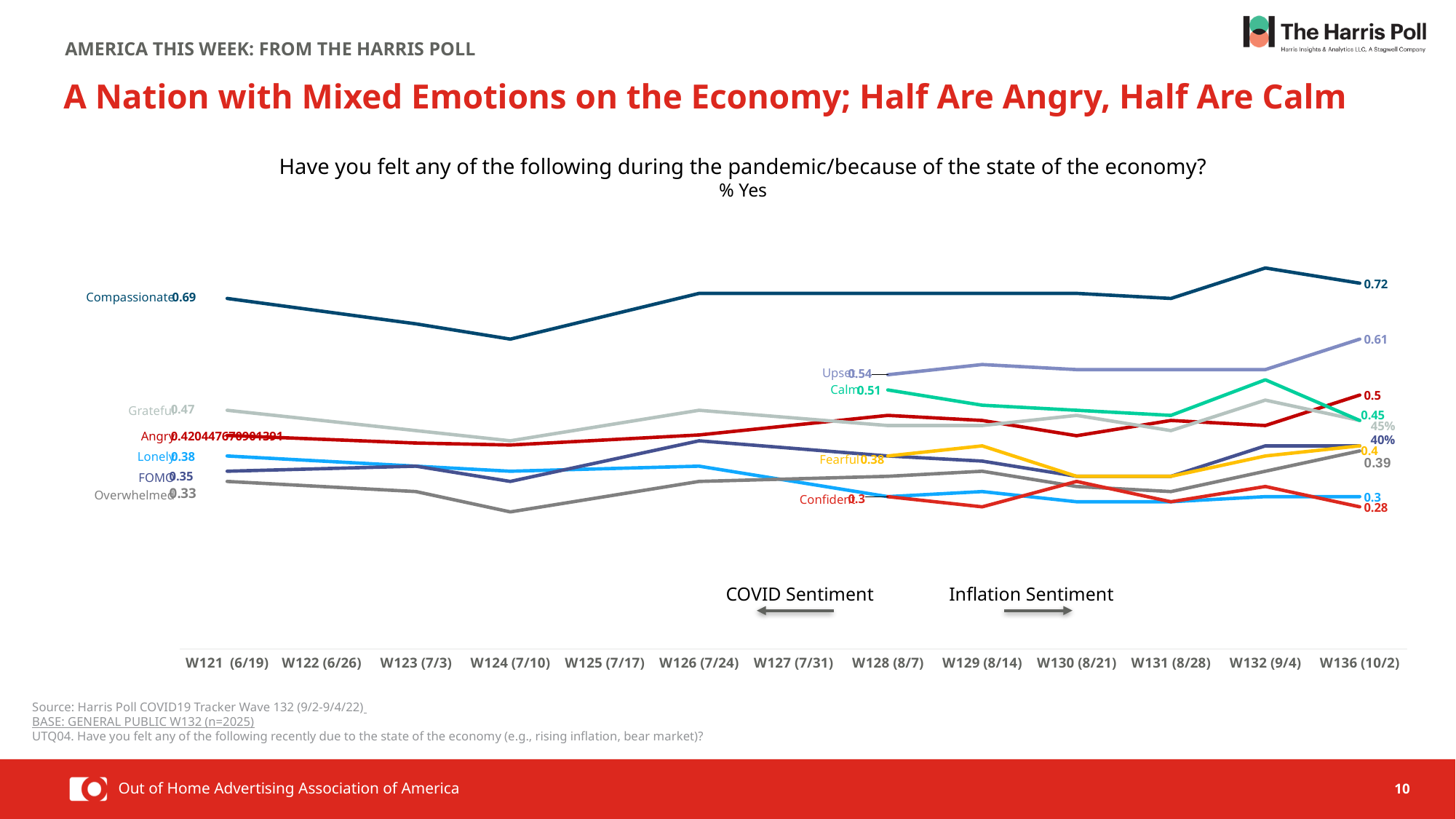
What is the value for Upset at W128 (8/7)? 0.54 What is the value for Compassionate at W136 (10/2)? 0.72 What is the value for Overwhelmed at W121 (6/19)? 0.33 What is the value for Compassionate at W121 (6/19)? 0.69 At W128 (8/7), which is larger, Upset or Calm? Upset What kind of chart is shown on the slide? line chart What is the value for Calm at W128 (8/7)? 0.51 What is the value for Grateful at W121 (6/19)? 0.47 What is the first wave label on the x axis? W121 (6/19) Which emotion has the highest value at W136 (10/2)? Compassionate How many survey waves are shown along the x axis? 13 By how much did the Compassionate value change from W121 (6/19) to W136 (10/2)? 0.03